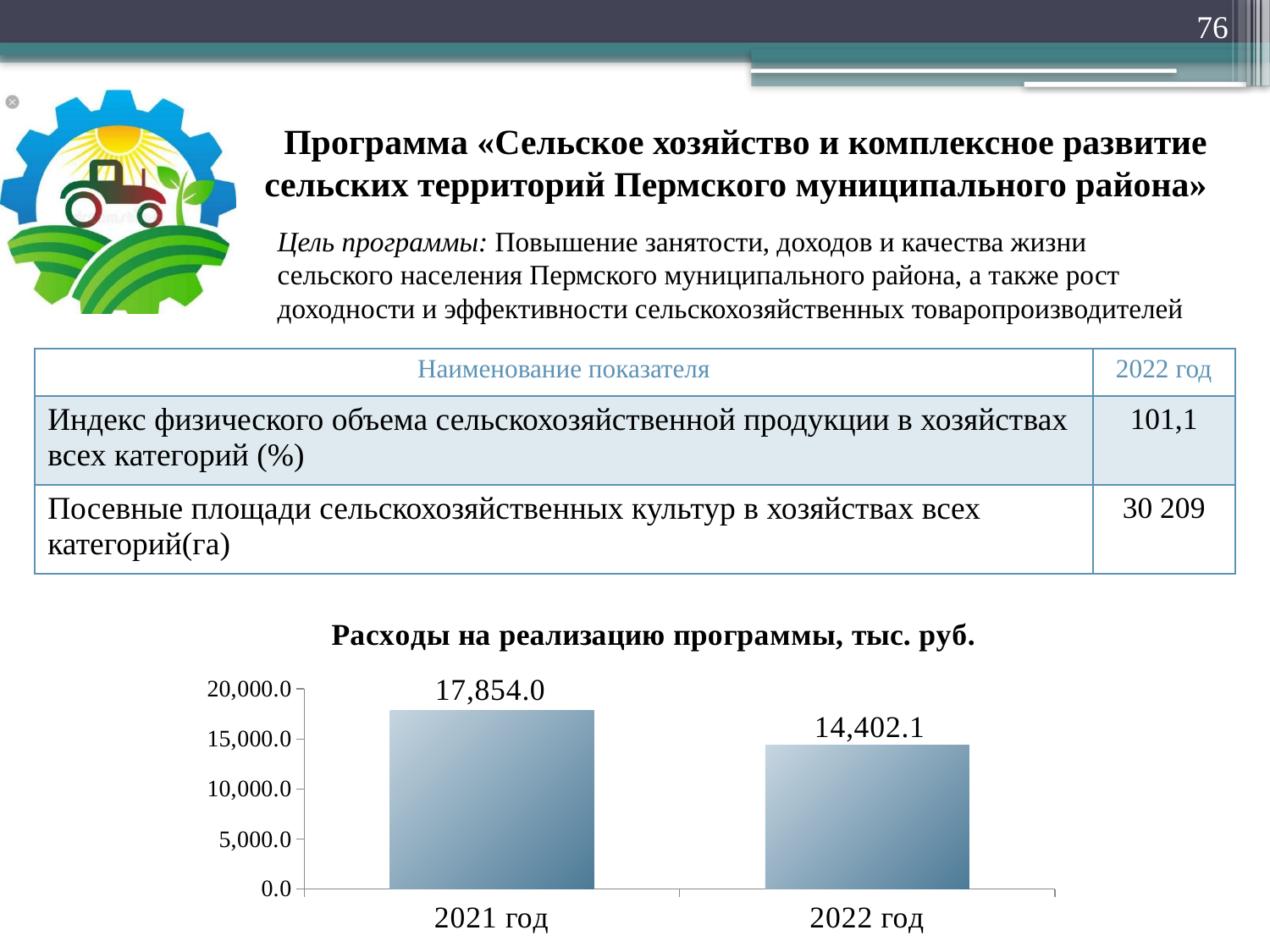
How many categories are shown in the chart 'Расходы на реализацию программы, тыс. руб.'? 2 Do the values in the chart 'Расходы на реализацию программы, тыс. руб.' rise or fall from 2021 год to 2022 год? fall What is the difference between the values for 2021 год and 2022 год in the chart 'Расходы на реализацию программы, тыс. руб.'? 3,451.9 In the chart 'Расходы на реализацию программы, тыс. руб.', is the value for 2022 год greater or less than 15,000.0? less Which year has the lowest value in the chart 'Расходы на реализацию программы, тыс. руб.'? 2022 год In the chart 'Расходы на реализацию программы, тыс. руб.', is the value for 2021 год greater or less than 15,000.0? greater What is the value for 2022 год in the chart 'Расходы на реализацию программы, тыс. руб.'? 14,402.1 In the chart 'Расходы на реализацию программы, тыс. руб.', which is larger: the value for 2021 год or for 2022 год? 2021 год What is the value for 2021 год in the chart 'Расходы на реализацию программы, тыс. руб.'? 17,854.0 What is the title of the chart on the slide? Расходы на реализацию программы, тыс. руб. What kind of chart is 'Расходы на реализацию программы, тыс. руб.'? bar chart Which year has the highest value in the chart 'Расходы на реализацию программы, тыс. руб.'? 2021 год